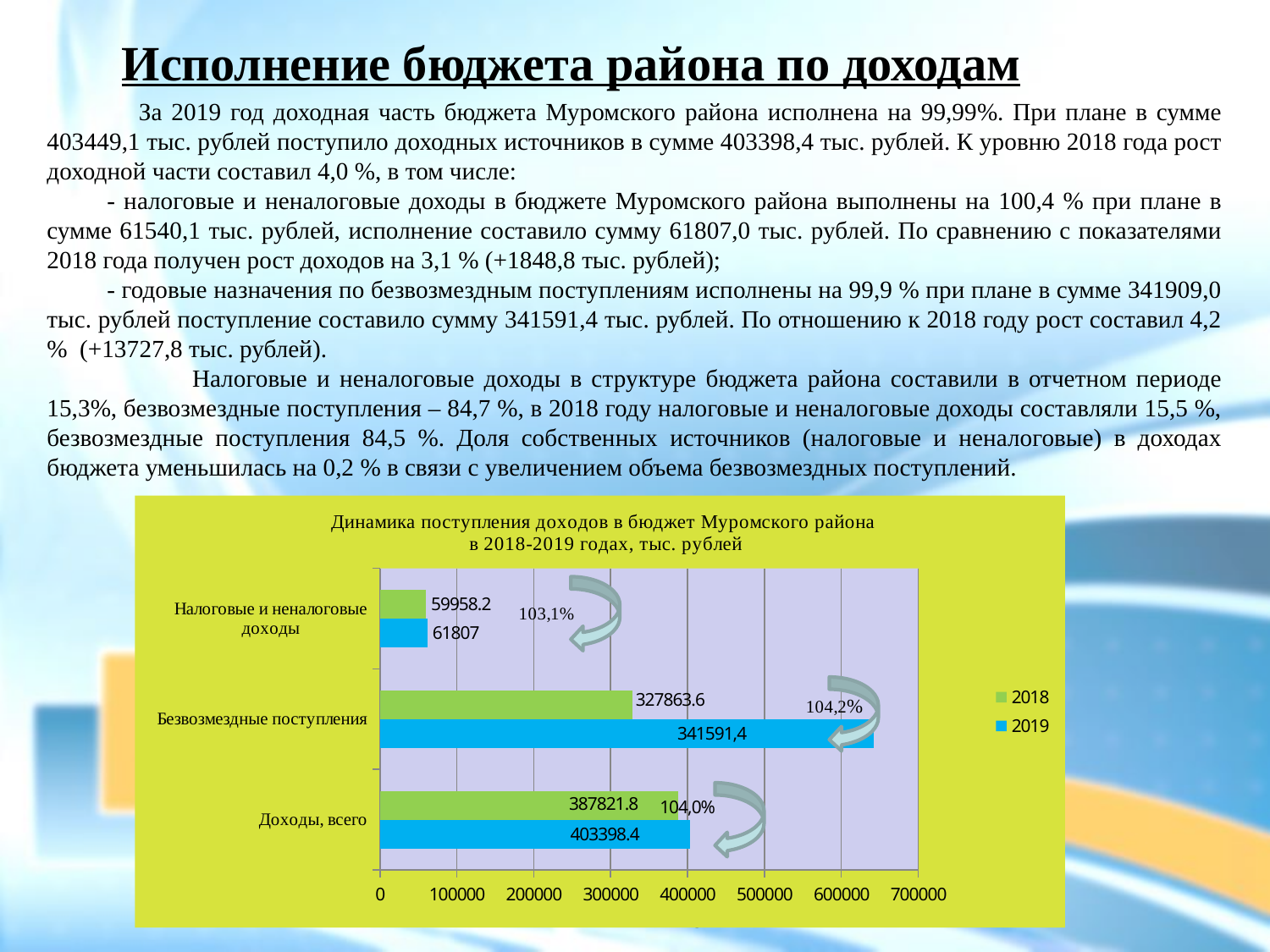
How many categories are shown on the chart? 3 How many series does the chart legend list? 2 What is the 2018 value for Безвозмездные поступления? 327863.6 What is the 2018 value for Налоговые и неналоговые доходы? 59958.2 What is the difference between the 2019 and 2018 values for Налоговые и неналоговые доходы? 1848.8 What is the 2019 value for Доходы, всего? 403398.4 Is the 2018 value for Налоговые и неналоговые доходы greater or less than 100000? less What is the 2019 value for Налоговые и неналоговые доходы? 61807 What type of chart is shown on the slide? bar chart What is the title of the chart? Динамика поступления доходов в бюджет Муромского района в 2018-2019 годах, тыс. рублей For Доходы, всего, which year has the larger value, 2018 or 2019? 2019 What is the difference between the 2019 and 2018 values for Доходы, всего? 15576.6